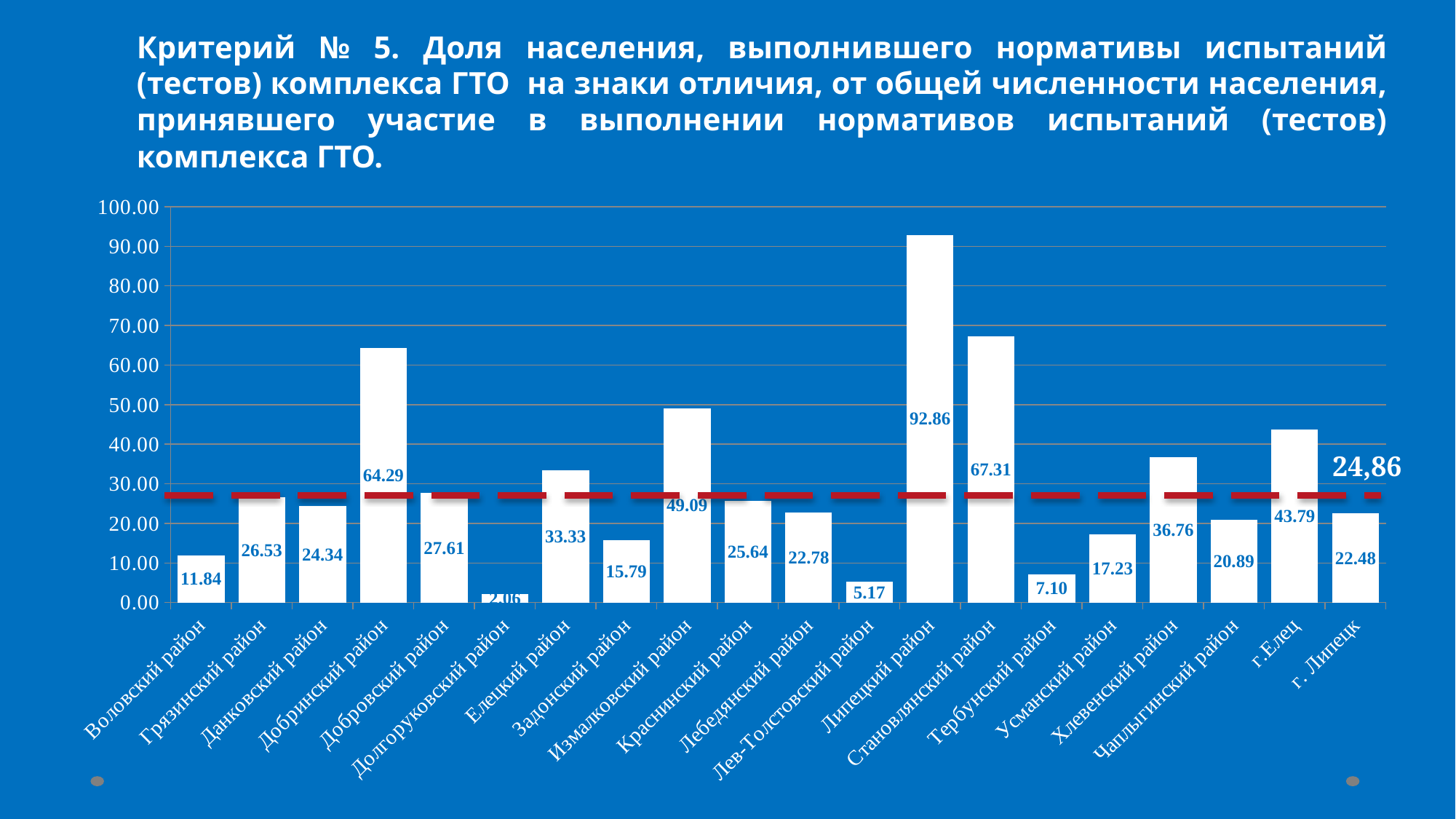
Which is larger, the value for Измалковский район or the value for Хлевенский район? Измалковский район What is the value for Липецкий район? 92.86 What is the value for Тербунский район? 7.10 What is the difference between the values for Липецкий район and Становлянский район? 25.55 What type of chart is shown on the slide? Bar chart What is the value for г.Елец? 43.79 How many districts/cities are shown on the x axis? 20 Is the value for Становлянский район greater or less than 60.00? greater Which district has the highest value? Липецкий район Which district has the lowest value? Долгоруковский район What is the value for Добринский район? 64.29 What value is labelled on the red dashed horizontal line? 24,86